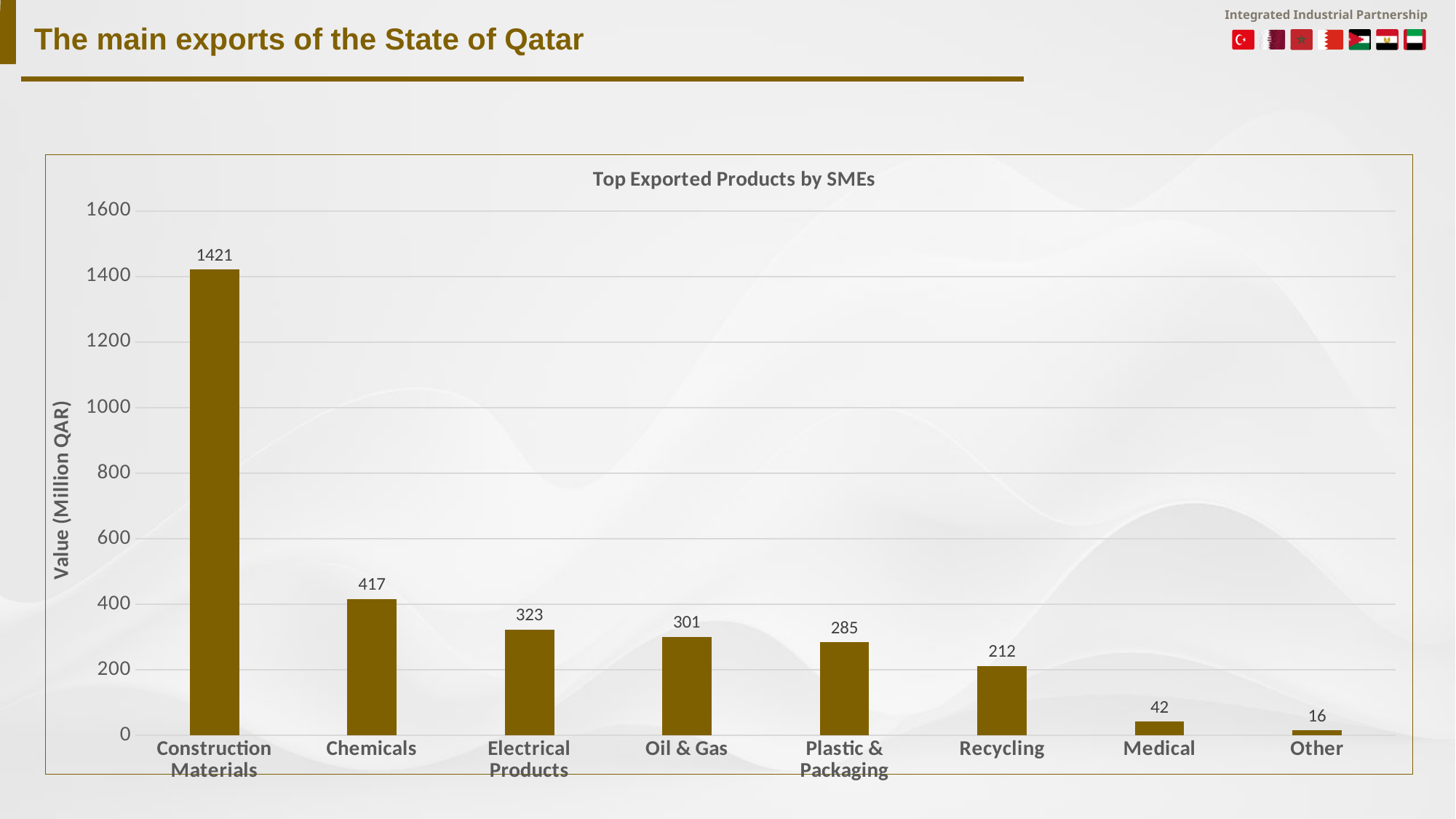
What is the value for Medical? 42 Which category has the lowest value? Other What is the title of the chart? Top Exported Products by SMEs What kind of chart is shown on the slide? bar chart Is the value for Electrical Products greater or less than 400? less Which is larger, the value for Oil & Gas or the value for Plastic & Packaging? Oil & Gas What is the value for Construction Materials? 1421 How many categories are shown on the x axis? 8 Which category has the highest value? Construction Materials What is the value for Chemicals? 417 What is the value for Recycling? 212 What is the difference between the values for Chemicals and Electrical Products? 94